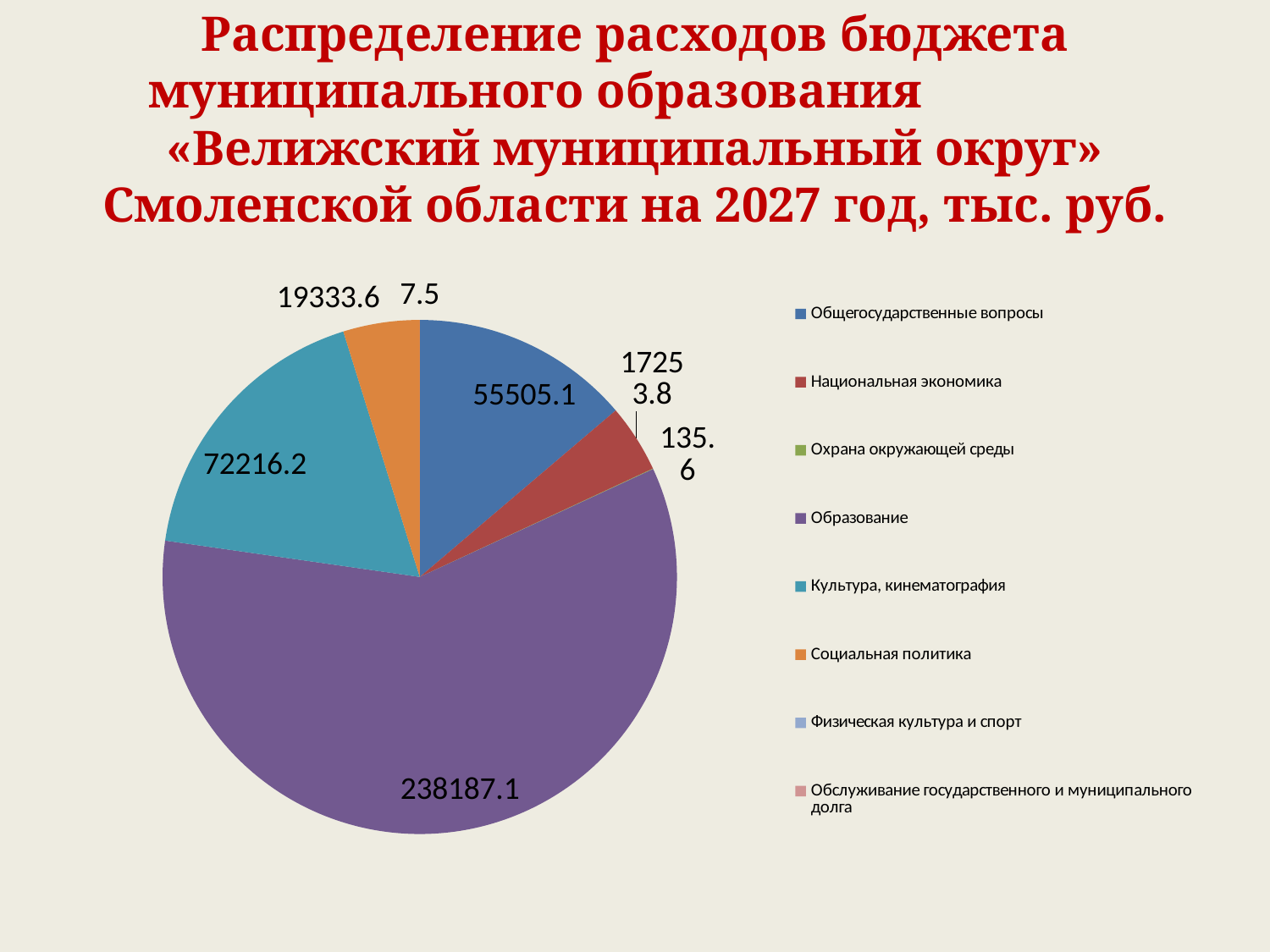
What is the difference between the values for Культура, кинематография and Общегосударственные вопросы? 16711.1 Which category has the largest slice of the pie? Образование What is the value for Национальная экономика? 17253.8 What is the value for Общегосударственные вопросы? 55505.1 What is the value for Культура, кинематография? 72216.2 What is the value for Социальная политика? 19333.6 What is the value for Образование? 238187.1 How many categories does the legend list? 8 Which is larger, Культура, кинематография or Общегосударственные вопросы? Культура, кинематография What kind of chart is shown on the slide? pie chart